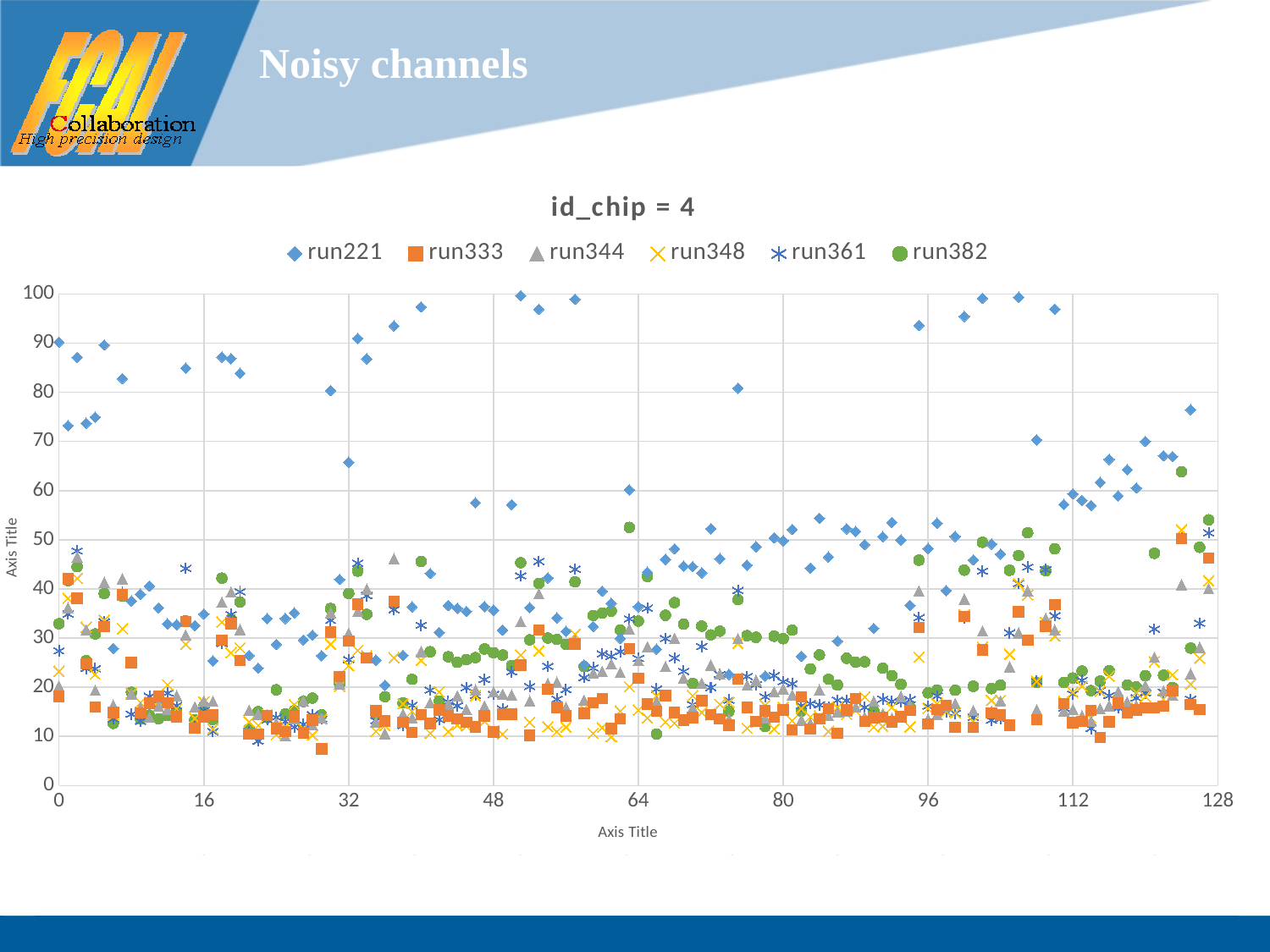
What is the highest value shown on the y axis? 100 What is the label of the x axis? Axis Title What kind of chart is shown on the slide? scatter chart What is the title of the chart? id_chip = 4 Is the value for run333 at x = 0 greater or less than 30? less Is the value for run221 at x = 0 greater or less than 80? greater Which series reaches the highest values on the chart? run221 How many series does the legend list? 6 At x = 0, which series has the larger value, run221 or run382? run221